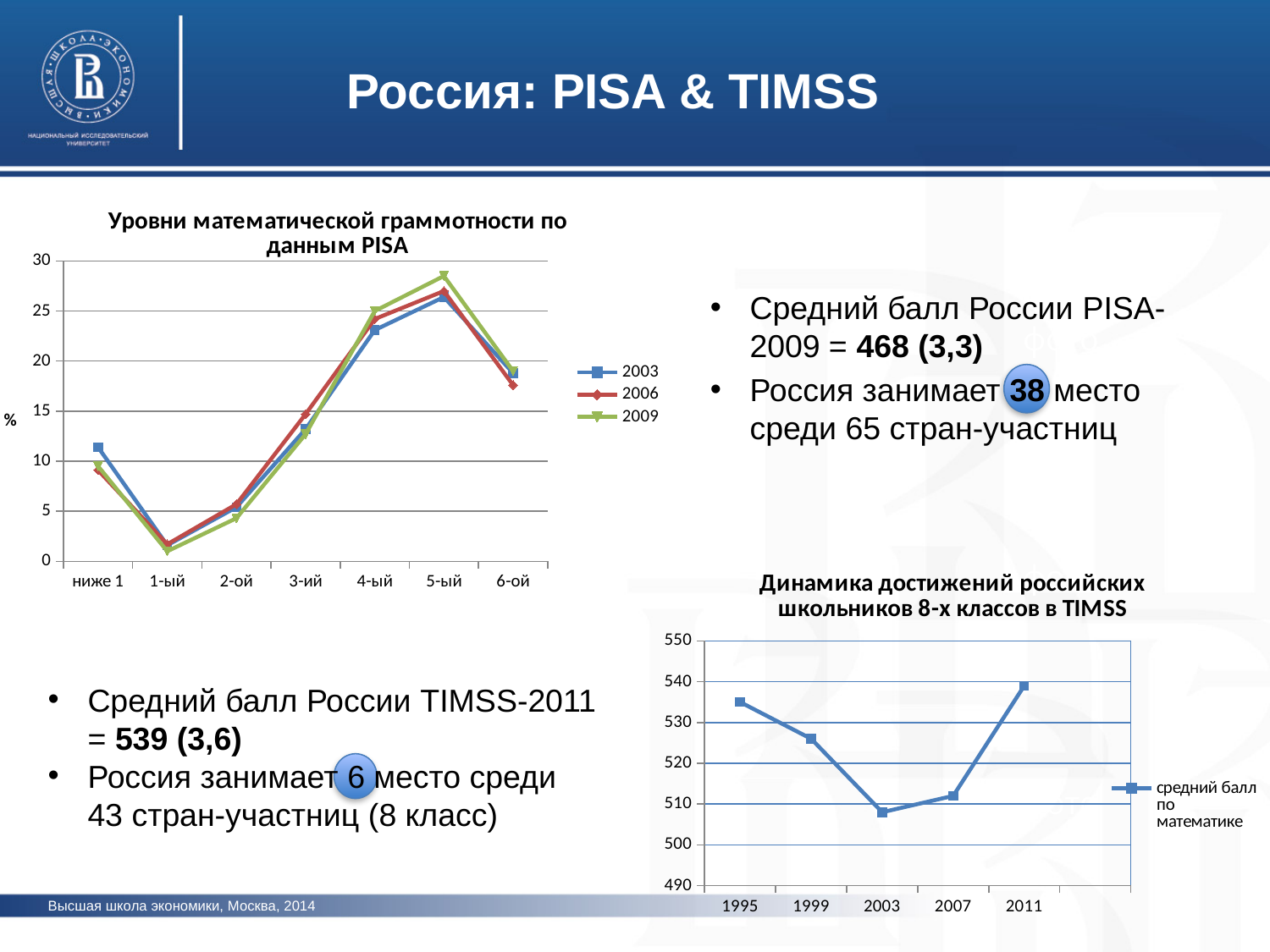
In the chart 'Уровни математической грамотности по данным PISA', is the 2003 value for '5-ый' greater or less than 25? greater In the chart 'Динамика достижений российских школьников 8-х классов в TIMSS', which year has the lowest value? 2003 What kind of chart is the chart titled 'Уровни математической грамотности по данным PISA'? line chart How many data points are plotted in the chart 'Динамика достижений российских школьников 8-х классов в TIMSS'? 5 In the chart 'Динамика достижений российских школьников 8-х классов в TIMSS', is the value for 2003 greater or less than 510? less In the chart 'Уровни математической грамотности по данным PISA', which category has the lowest value for the 2009 series? 1-ый What kind of chart is the chart titled 'Динамика достижений российских школьников 8-х классов в TIMSS'? line chart In the chart 'Уровни математической грамотности по данным PISA', which category has the highest value for the 2009 series? 5-ый How many series does the legend of the chart 'Уровни математической грамотности по данным PISA' list? 3 In the chart 'Уровни математической грамотности по данным PISA', for the category '6-ой', which series has the larger value, 2006 or 2009? 2009 How many categories are shown on the x axis of the chart 'Уровни математической грамотности по данным PISA'? 7 In the chart 'Уровни математической грамотности по данным PISA', is the 2003 value for 'ниже 1' greater or less than 10? greater